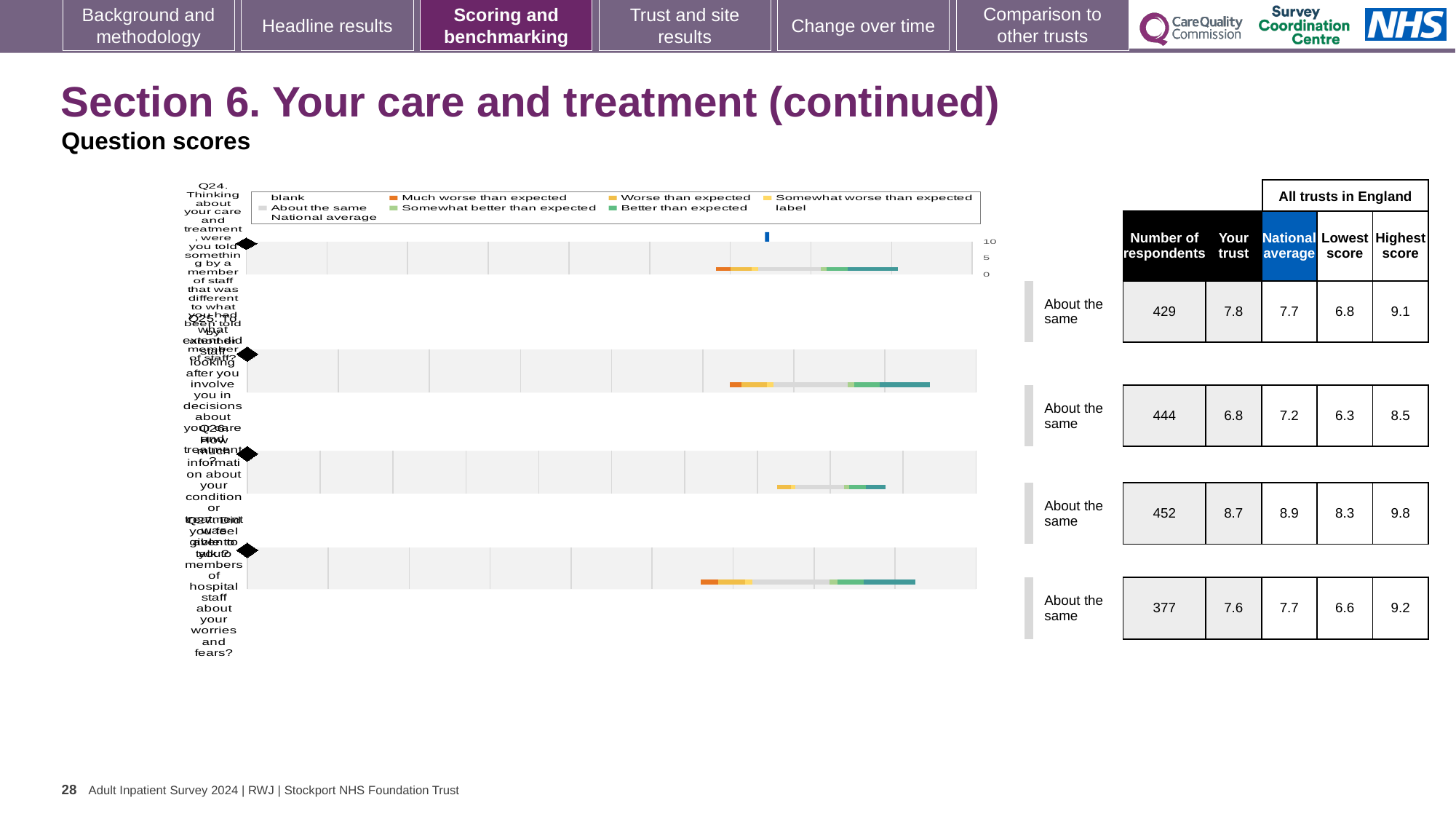
For the Q27 chart (bottom), what is the highest score among all trusts in England? 9.2 What kind of chart is used for each question score on this slide? bar chart For the Q24 chart (top), what is the 'Your trust' score shown in the table? 7.8 For the Q25 chart, what is the difference between the national average and the 'Your trust' score? 0.4 For the Q26 chart, is the 'Your trust' score or the national average larger? National average Which question (Q24 to Q27) has the fewest respondents? Q27 How many question charts (Q24 to Q27) are shown on the slide? 4 For the Q25 chart (second from top), what is the national average score? 7.2 What benchmark category is shown next to each of the four question charts? About the same Which of the four questions (Q24 to Q27) has the lowest 'Your trust' score? Q25 Which of the four questions (Q24 to Q27) has the highest 'Your trust' score? Q26 For the Q26 chart (third from top), how many respondents are listed? 452